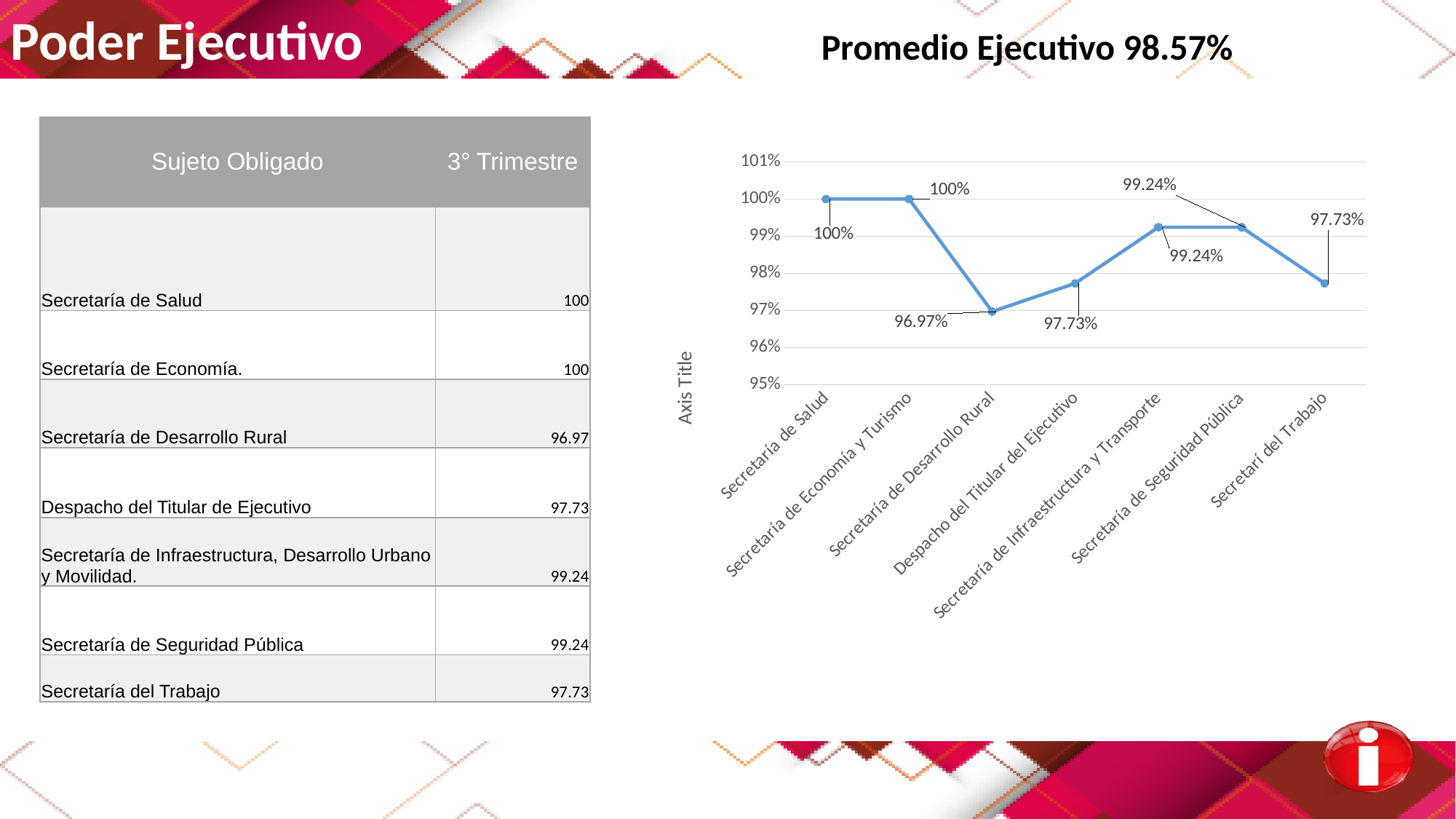
Which is larger: the value for Secretaría de Seguridad Pública or the value for Secretarí del Trabajo? Secretaría de Seguridad Pública Which category has the lowest value in the chart? Secretaría de Desarrollo Rural Is the value for Secretaría de Desarrollo Rural greater or less than 98%? less How many categories are plotted on the x axis of the chart? 7 What is the value for Secretaría de Salud in the chart? 100% What is the title shown on the vertical axis of the chart? Axis Title What type of chart is shown on the slide? line chart What is the value for Secretaría de Seguridad Pública in the chart? 99.24% Does the line rise or fall from Secretaría de Economía y Turismo to Secretaría de Desarrollo Rural? fall What is the difference between the value for Secretaría de Salud and the value for Secretaría de Desarrollo Rural? 3.03 percentage points What is the value for Despacho del Titular del Ejecutivo in the chart? 97.73% What is the value for Secretaría de Desarrollo Rural in the chart? 96.97%